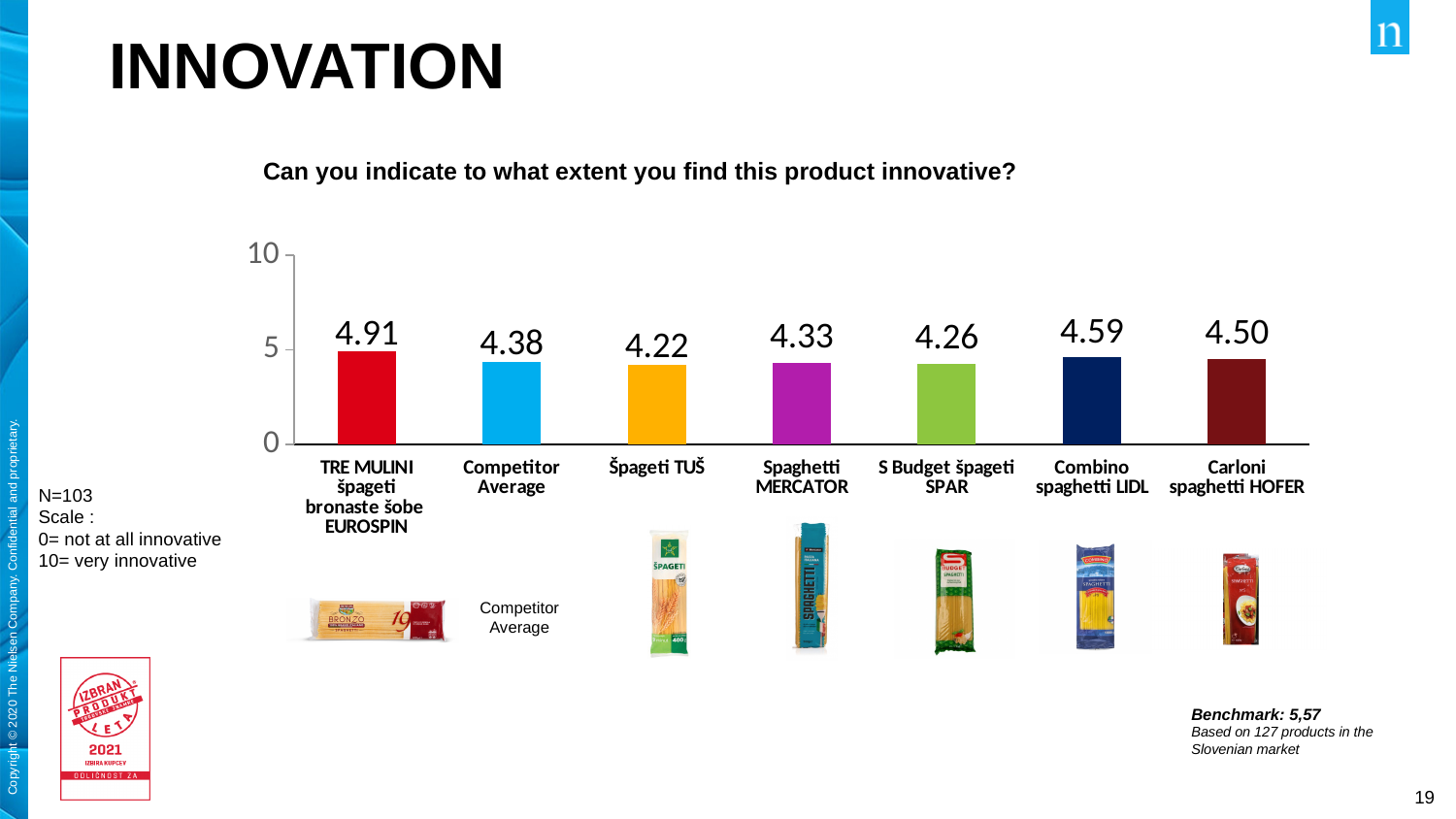
What is the benchmark value stated on the slide? 5,57 How many bars are shown in the chart? 7 What is the value shown for Carloni spaghetti HOFER? 4.50 Which product has the lowest innovation score? Špageti TUŠ What is the innovation score for Combino spaghetti LIDL? 4.59 What is the difference between the scores of TRE MULINI špageti bronaste šobe EUROSPIN and Competitor Average? 0.53 Is the value for Špageti TUŠ greater or less than 5? less Which product has the highest innovation score? TRE MULINI špageti bronaste šobe EUROSPIN What type of chart is shown on the slide? Bar chart What is the value shown for Competitor Average? 4.38 What is the innovation score for TRE MULINI špageti bronaste šobe EUROSPIN? 4.91 Which has a higher score, Spaghetti MERCATOR or S Budget špageti SPAR? Spaghetti MERCATOR